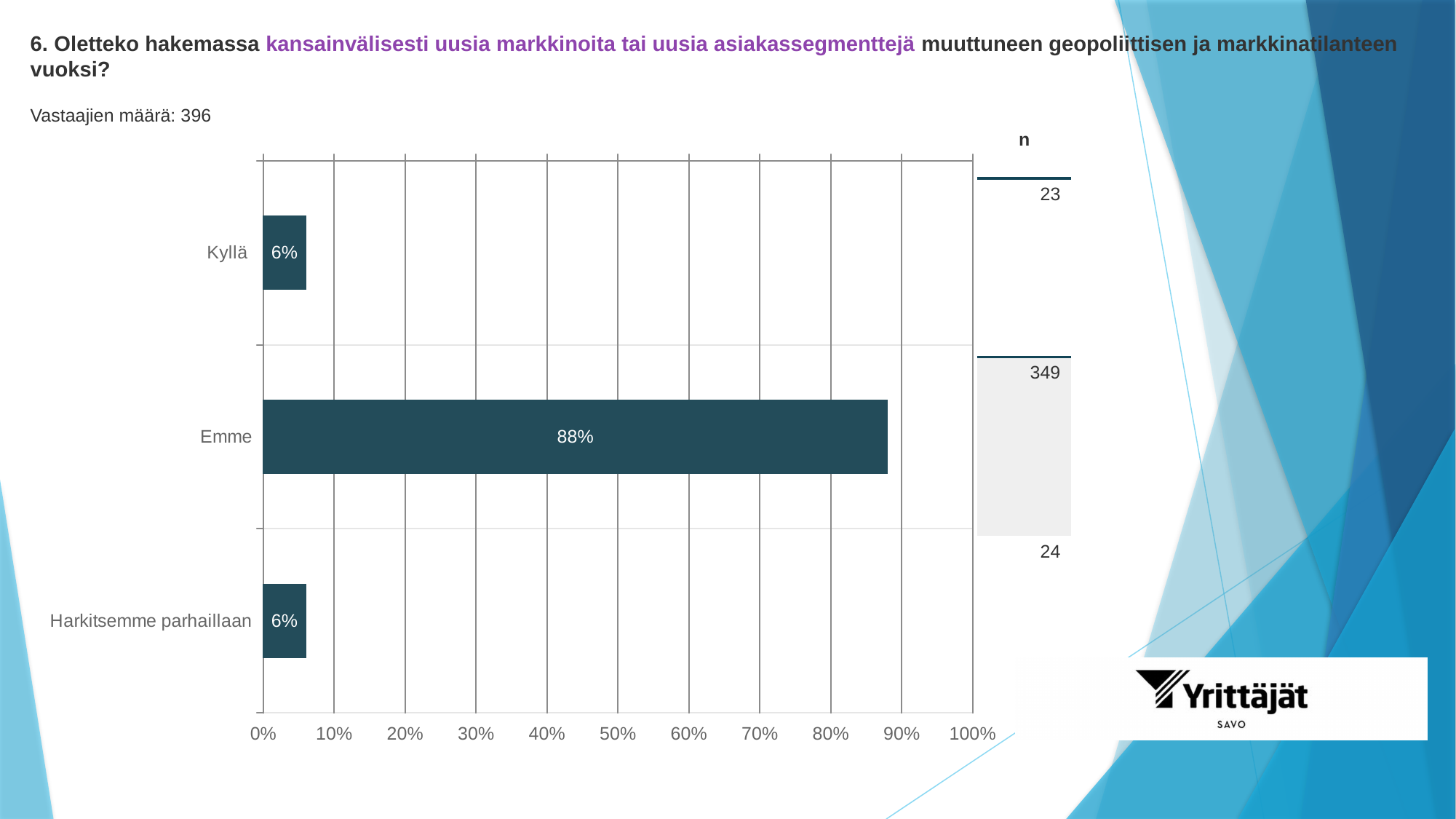
Is the value for "Emme" greater or less than 80%? greater How many categories are shown in the chart? 3 What percentage is shown for "Kyllä"? 6% What is the n value shown for "Emme"? 349 What is the difference in percentage points between "Emme" and "Kyllä"? 82 What is the n value shown for "Kyllä"? 23 What percentage is shown for "Emme"? 88% What percentage is shown for "Harkitsemme parhaillaan"? 6% Which category has the highest percentage? Emme What is the total number of respondents (Vastaajien määrä) stated on the slide? 396 What kind of chart is shown on the slide? Bar chart What is the n value shown for "Harkitsemme parhaillaan"? 24